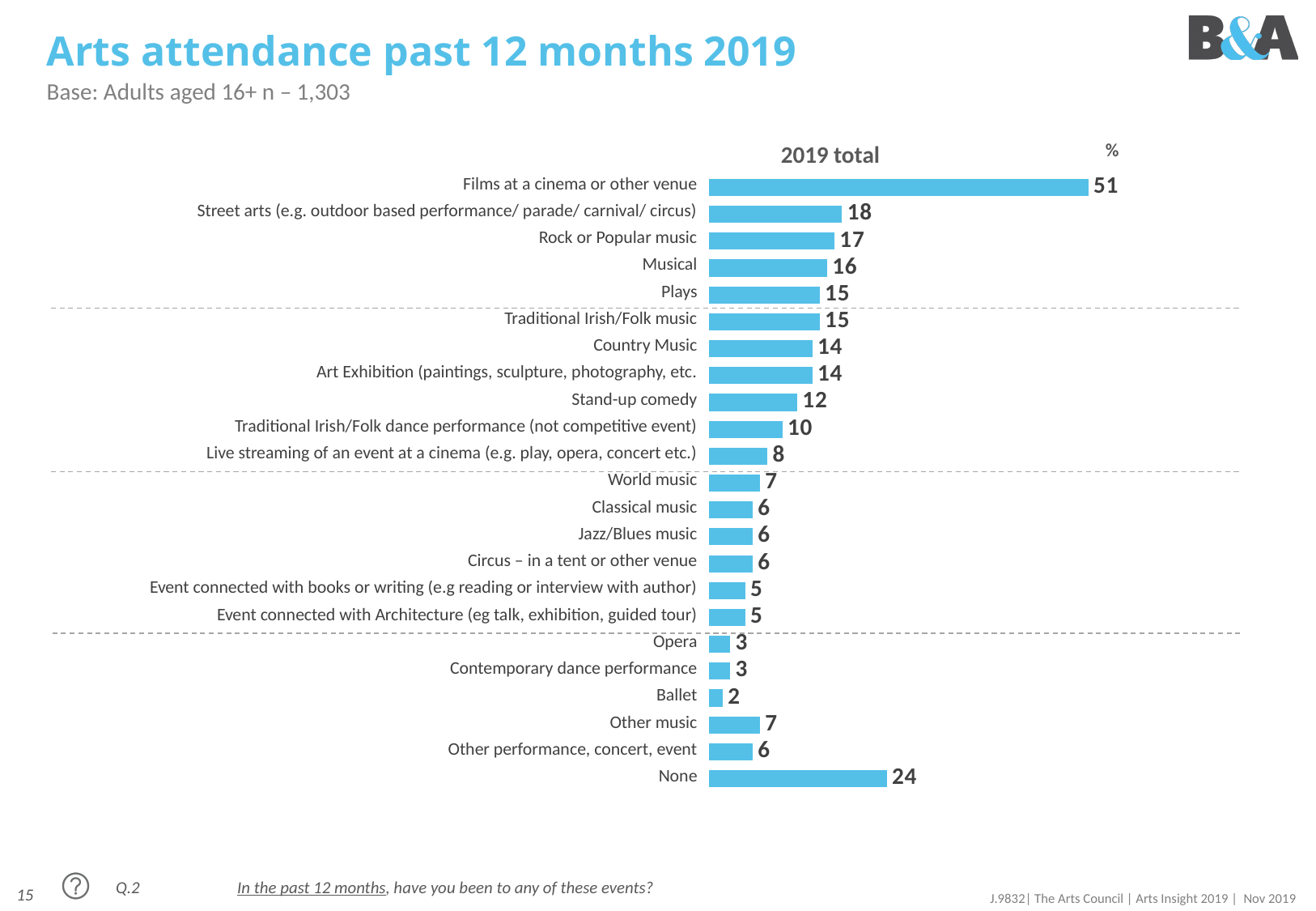
Which category has the highest value? Films at a cinema or other venue What is the value for Stand-up comedy? 12 What is the difference between the values for Films at a cinema or other venue and None? 27 What is the value for Street arts (e.g. outdoor based performance/ parade/ carnival/ circus)? 18 How many categories are shown in the chart? 23 Which is larger, the value for Country Music or the value for World music? Country Music Which category has the lowest value? Ballet What is the value for None? 24 What kind of chart is shown on the slide? Bar chart What is the title shown above the bars in the chart? 2019 total What is the difference between the values for Rock or Popular music and Musical? 1 What is the value for Films at a cinema or other venue? 51